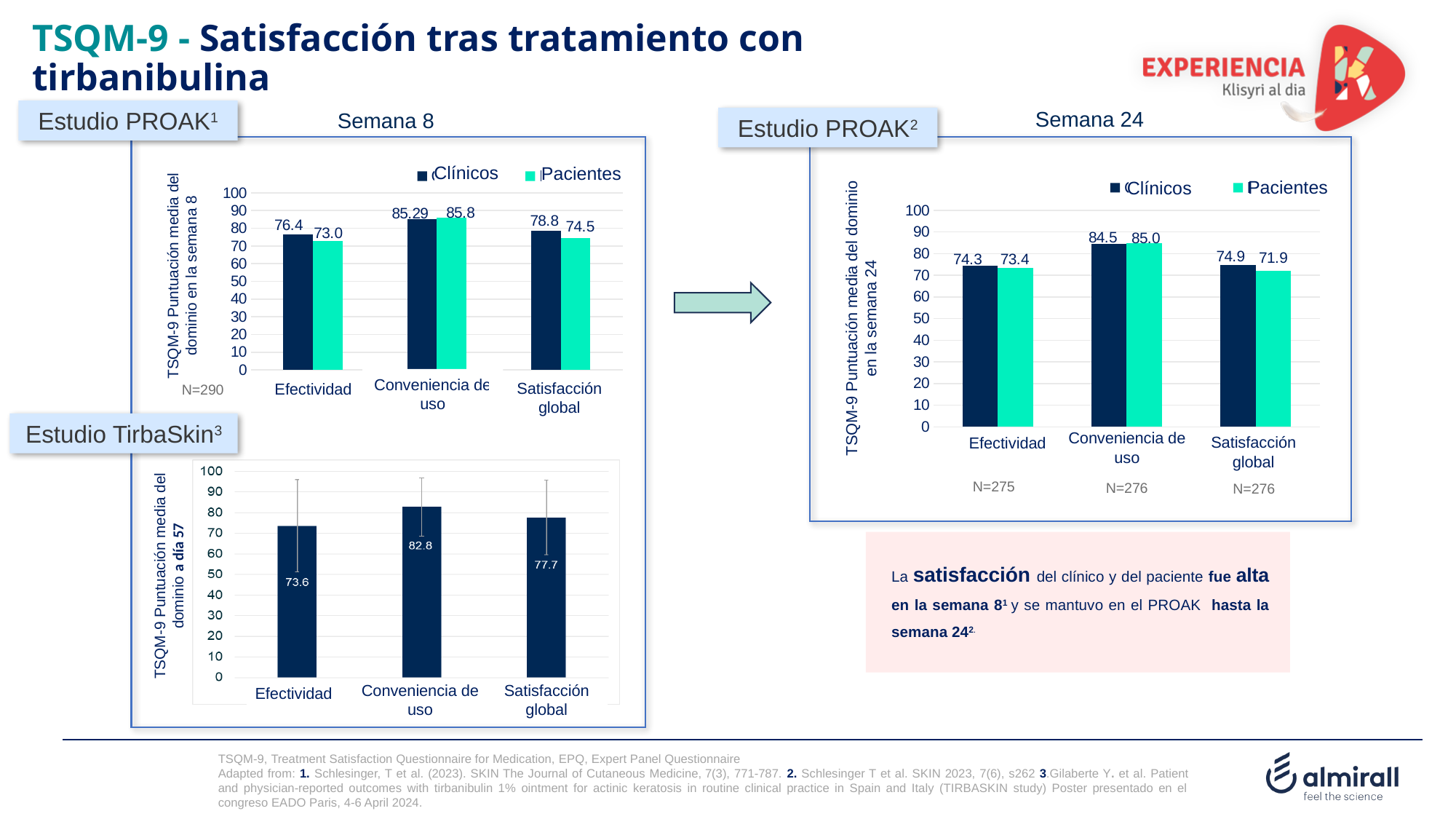
In the Estudio TirbaSkin chart, which category has the lowest value? Efectividad In the Semana 24 chart (Estudio PROAK), which category has the lowest Pacientes value? Satisfacción global What kind of chart is the Estudio TirbaSkin chart? Bar chart In the Semana 24 chart (Estudio PROAK), what is the Pacientes value for Satisfacción global? 71.9 In the Estudio TirbaSkin chart, what is the value for Conveniencia de uso? 82.8 In the Semana 24 chart (Estudio PROAK), which is larger for Efectividad, the Clínicos value or the Pacientes value? Clínicos In the Semana 8 chart (Estudio PROAK), what is the difference between the Clínicos and Pacientes values for Satisfacción global? 4.3 In the Semana 24 chart (Estudio PROAK), how many series does the legend list? 2 In the Semana 8 chart (Estudio PROAK), what is the Pacientes value for Conveniencia de uso? 85.8 In the Estudio TirbaSkin chart, how many categories are shown on the x axis? 3 In the Semana 8 chart (Estudio PROAK), what is the Clínicos value for Efectividad? 76.4 In the Semana 8 chart (Estudio PROAK), which category has the highest Clínicos value? Conveniencia de uso